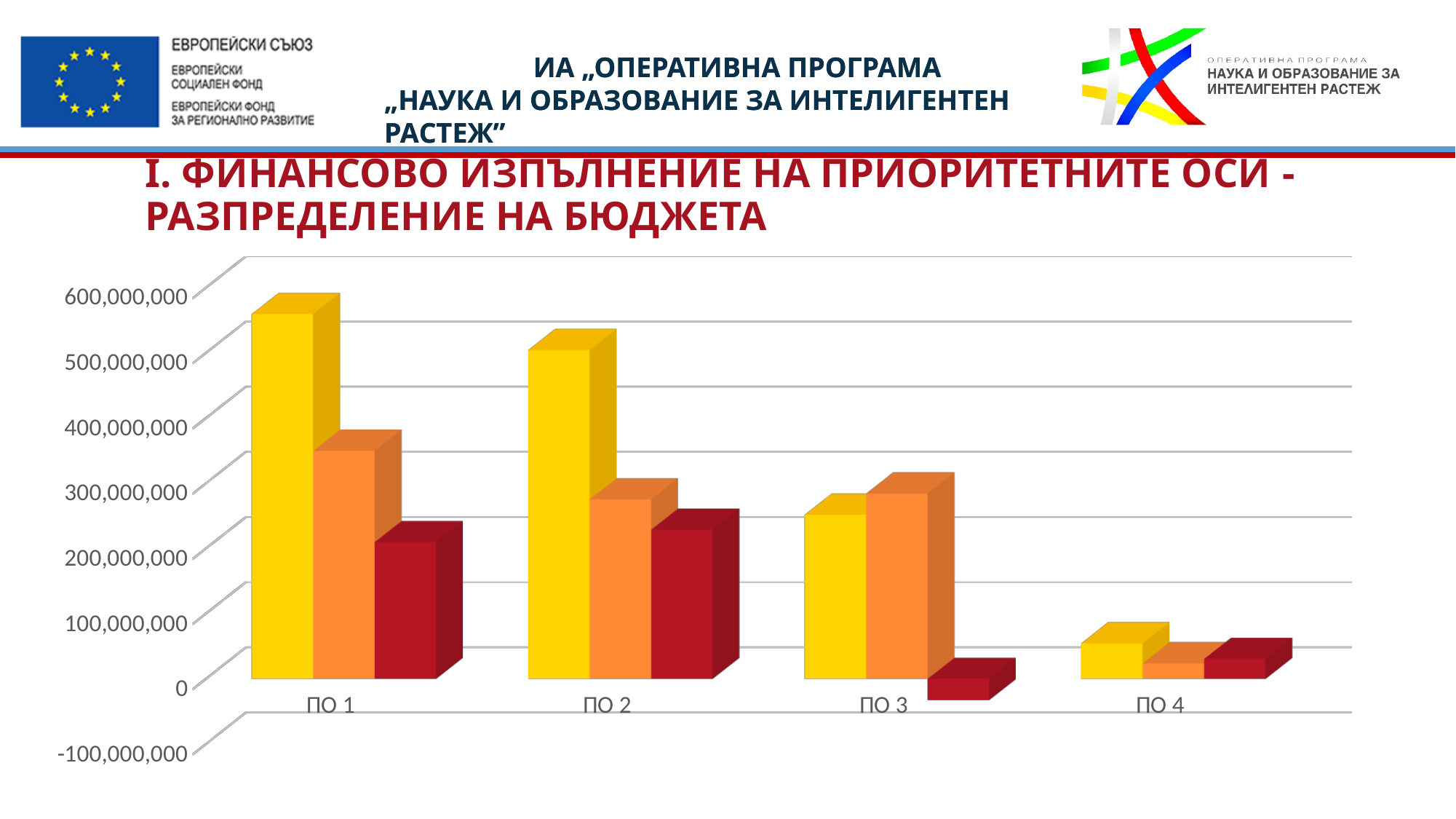
How many bars are plotted for each category in the chart? 3 Is the value of the orange bar for ПО 1 greater or less than 300,000,000? greater Which category has the tallest yellow bar? ПО 1 What kind of chart is shown on the slide? Bar chart Is the value of the red bar for ПО 3 greater or less than 0? less Is the value of the yellow bar for ПО 2 greater or less than 400,000,000? greater For ПО 3, which is larger: the yellow bar or the orange bar? The orange bar Do the yellow bars rise or fall from ПО 1 to ПО 4? Fall How many categories are shown on the x axis of the chart? 4 Which category has the lowest yellow bar? ПО 4